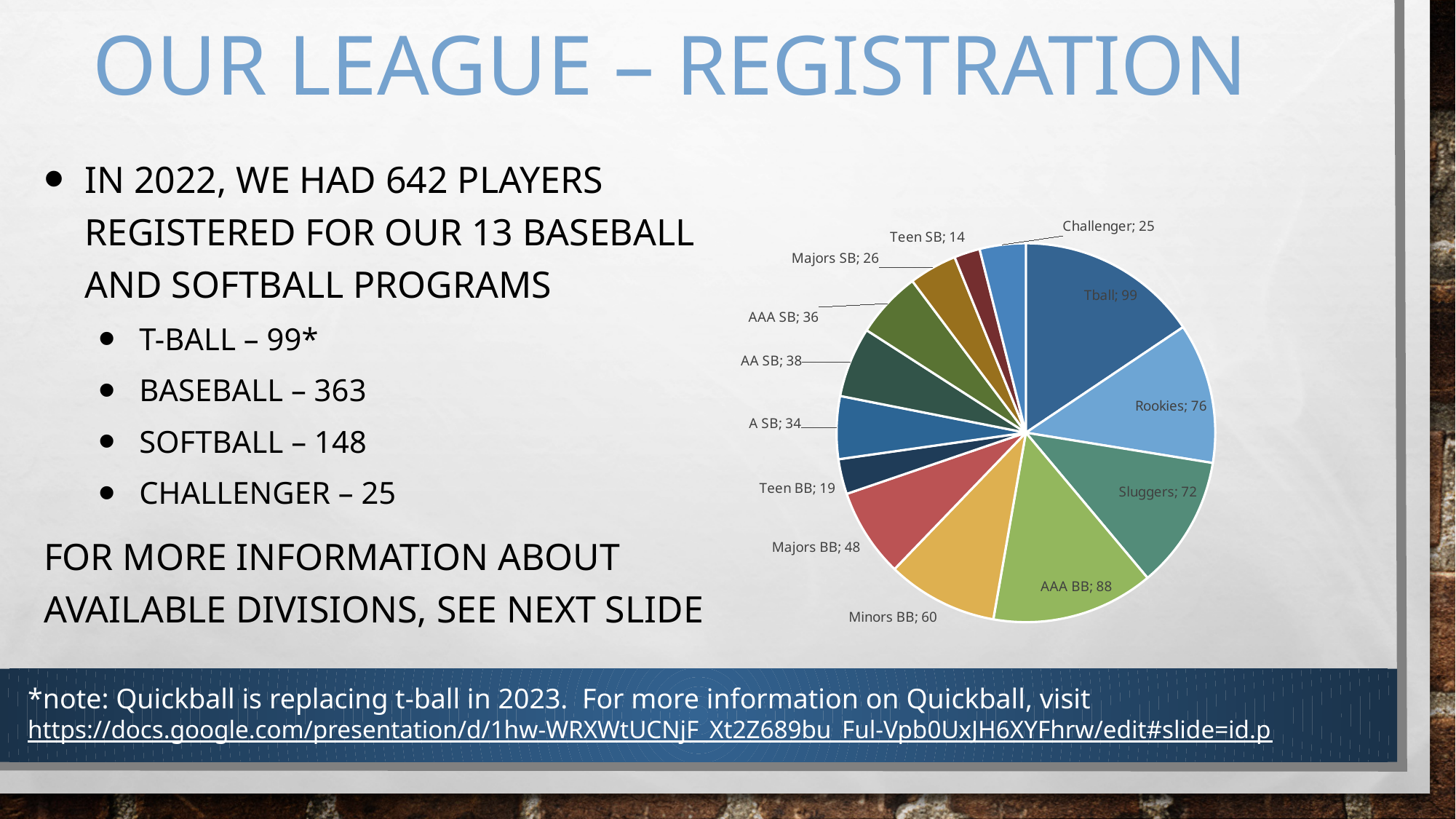
Which slice of the pie chart has the smallest value? Teen SB What is the value shown for Challenger in the pie chart? 25 What kind of chart is shown on the slide? pie chart What is the difference between the values for AAA BB and Sluggers in the pie chart? 16 What is the difference between the values for Tball and Rookies in the pie chart? 23 Which has a larger value in the pie chart, Majors BB or Majors SB? Majors BB Which slice of the pie chart has the largest value? Tball What is the value shown for Minors BB in the pie chart? 60 How many slices does the pie chart have? 13 What is the value shown for AA SB in the pie chart? 38 What is the value shown for AAA BB in the pie chart? 88 What is the value shown for Tball in the pie chart? 99